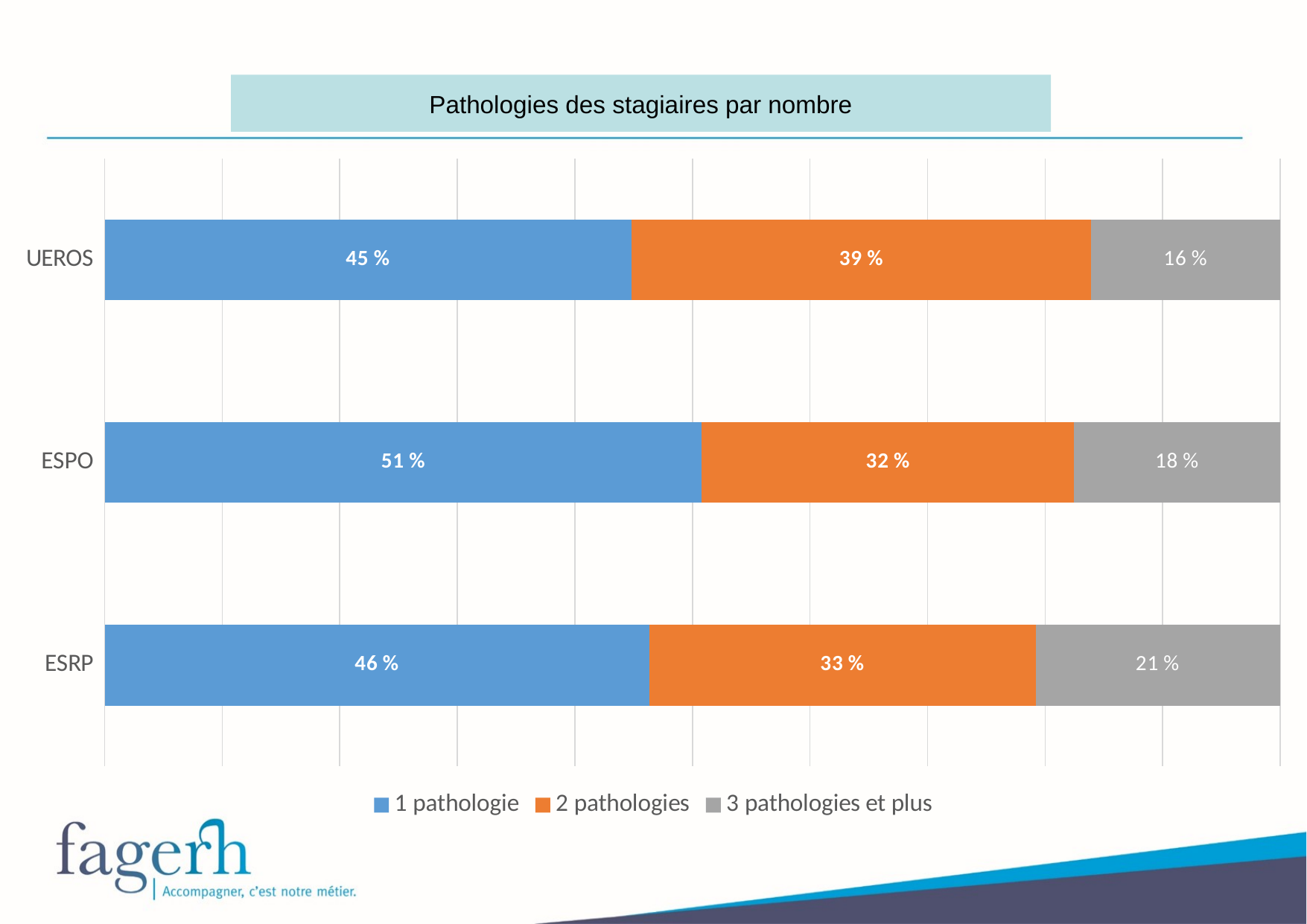
What is the title of the chart? Pathologies des stagiaires par nombre How many categories are shown on the y axis? 3 Which category has the highest value for '1 pathologie'? ESPO What is the value for '1 pathologie' for ESPO? 51 % What is the value for '2 pathologies' for UEROS? 39 % Which is larger: the '2 pathologies' value for UEROS or for ESRP? UEROS What is the value for '3 pathologies et plus' for ESRP? 21 % What is the total of the stacked bar for ESRP? 100 % What is the difference between the '1 pathologie' values for ESPO and UEROS? 6 % How many series does the legend list? 3 Which category has the lowest value for '3 pathologies et plus'? UEROS What kind of chart is shown? Stacked bar chart